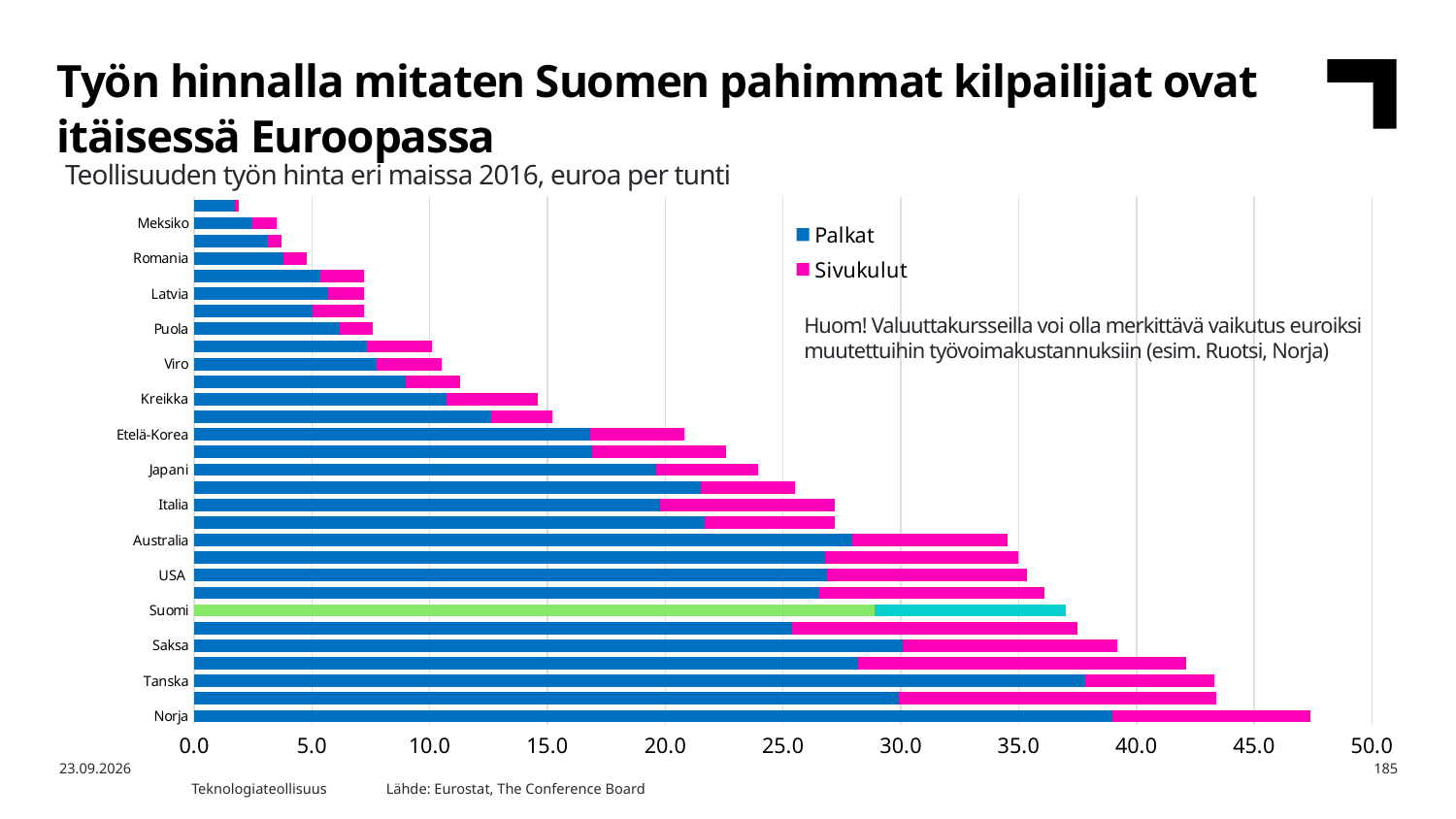
Which has the larger total bar, Saksa or Suomi? Saksa Which country has the highest total labour cost per hour in the chart? Norja Is the total value for Suomi greater or less than 35.0? greater Is the total value for Meksiko greater or less than 5.0? less Is the total value for Norja greater or less than 45.0? greater What kind of chart is shown on the slide? Stacked horizontal bar chart How many series does the legend list? 2 Which has the larger total bar, Italia or Japani? Italia How many country names are labelled on the vertical axis? 15 What are the two series named in the legend? Palkat and Sivukulut